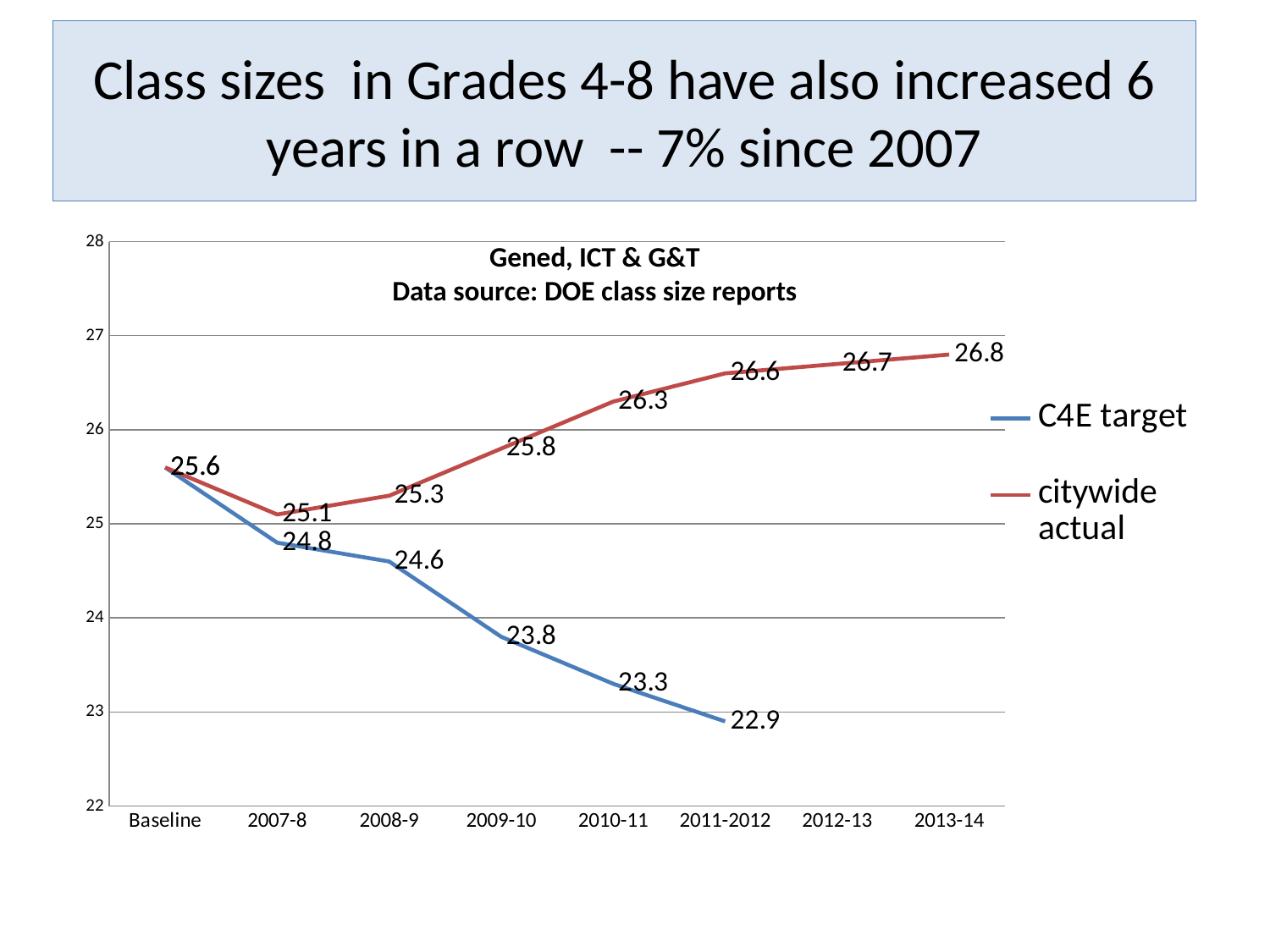
Which is larger in 2008-9, the citywide actual or the C4E target? citywide actual What is the C4E target value for 2011-2012? 22.9 What is the title of the chart? Gened, ICT & G&T Data source: DOE class size reports How many categories are shown on the x axis? 8 What type of chart is shown on the slide? Line chart What is the citywide actual value for 2009-10? 25.8 How many series does the legend list? 2 What is the difference between the citywide actual and the C4E target in 2010-11? 3.0 What is the citywide actual class size for 2013-14? 26.8 Does the C4E target line rise or fall from Baseline to 2011-2012? Fall In which year is the citywide actual class size lowest? 2007-8 In which year is the citywide actual class size highest? 2013-14